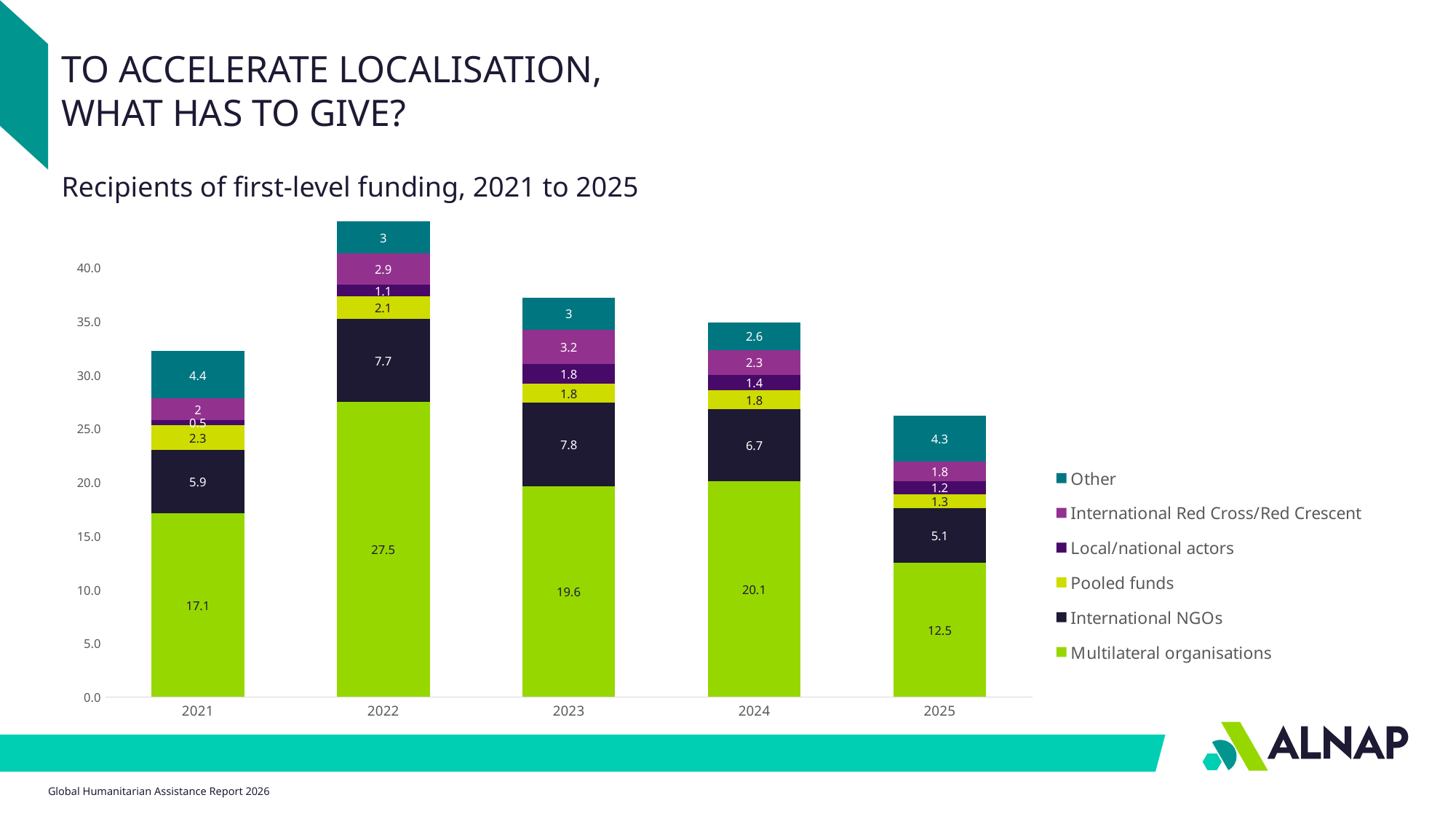
What is the difference between the Multilateral organisations values for 2022 and 2025? 15 What is the value for International NGOs in 2024? 6.7 Is the total of the stacked bar for 2022 greater or less than 40.0? greater In which year is the value for Multilateral organisations lowest? 2025 How many series does the legend list? 6 What is the value for Multilateral organisations in 2022? 27.5 Which is larger, the Other value for 2021 or for 2024? 2021 What is the value for Local/national actors in 2021? 0.5 What is the total of the stacked bar for 2025? 26.2 How many years are shown on the x axis? 5 In which year is the value for Multilateral organisations highest? 2022 What type of chart is shown on the slide? Stacked bar chart